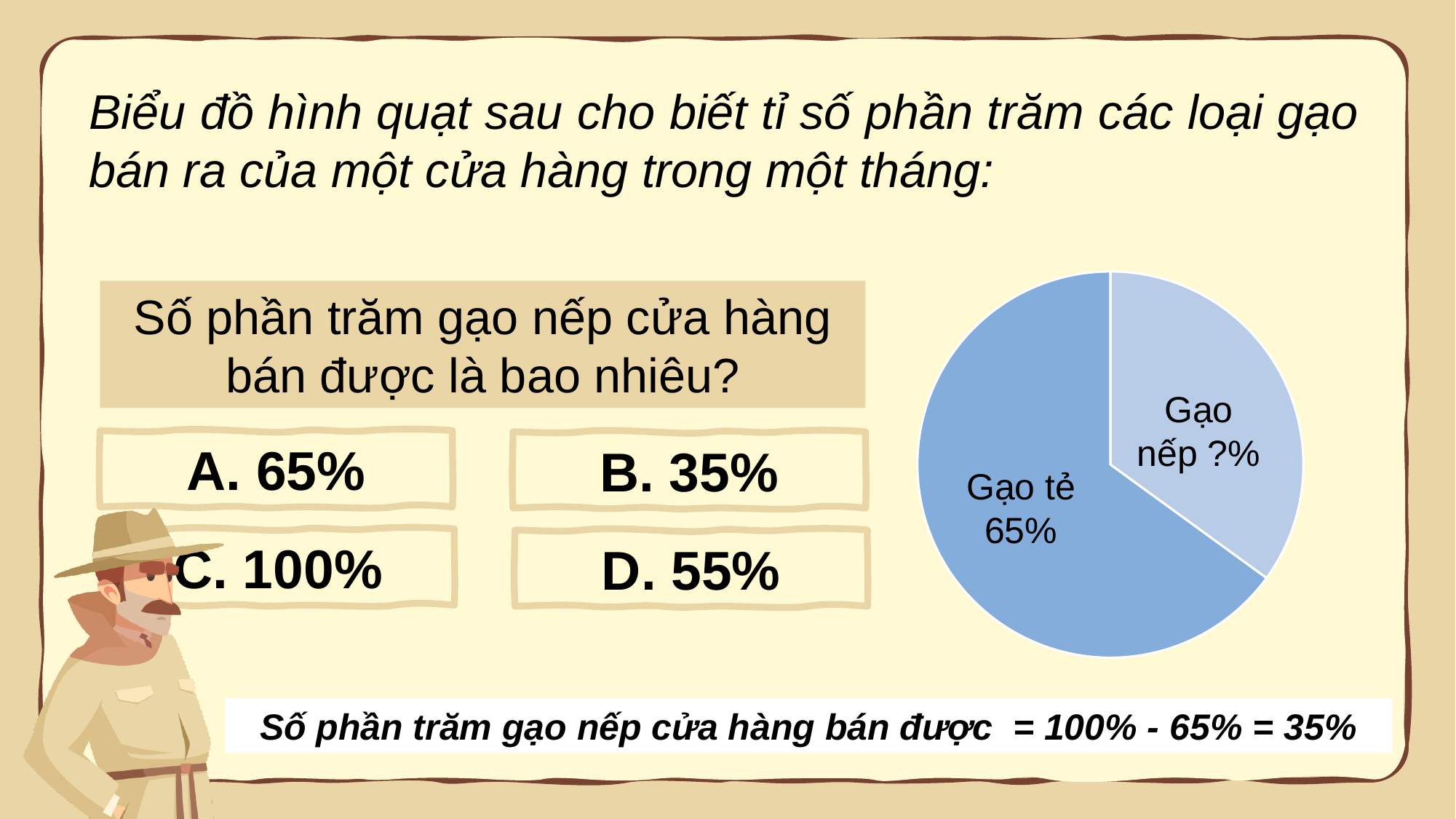
How many slices does the pie chart have? 2 Which is larger in the pie chart, Gạo tẻ or Gạo nếp? Gạo tẻ What share of the pie does Gạo nếp represent? 35% What value is printed on the Gạo nếp slice label in the pie chart? ?% Is the share for Gạo nếp greater or less than 50%? less Is the share for Gạo tẻ greater or less than 50%? greater Which slice of the pie chart is the largest? Gạo tẻ What kind of chart is shown on the slide? pie chart What is the difference between the shares of Gạo tẻ and Gạo nếp? 30% Which slice of the pie chart is the smallest? Gạo nếp Which slice of the pie chart is drawn in the darker blue colour? Gạo tẻ What percentage is shown for Gạo tẻ in the pie chart? 65%